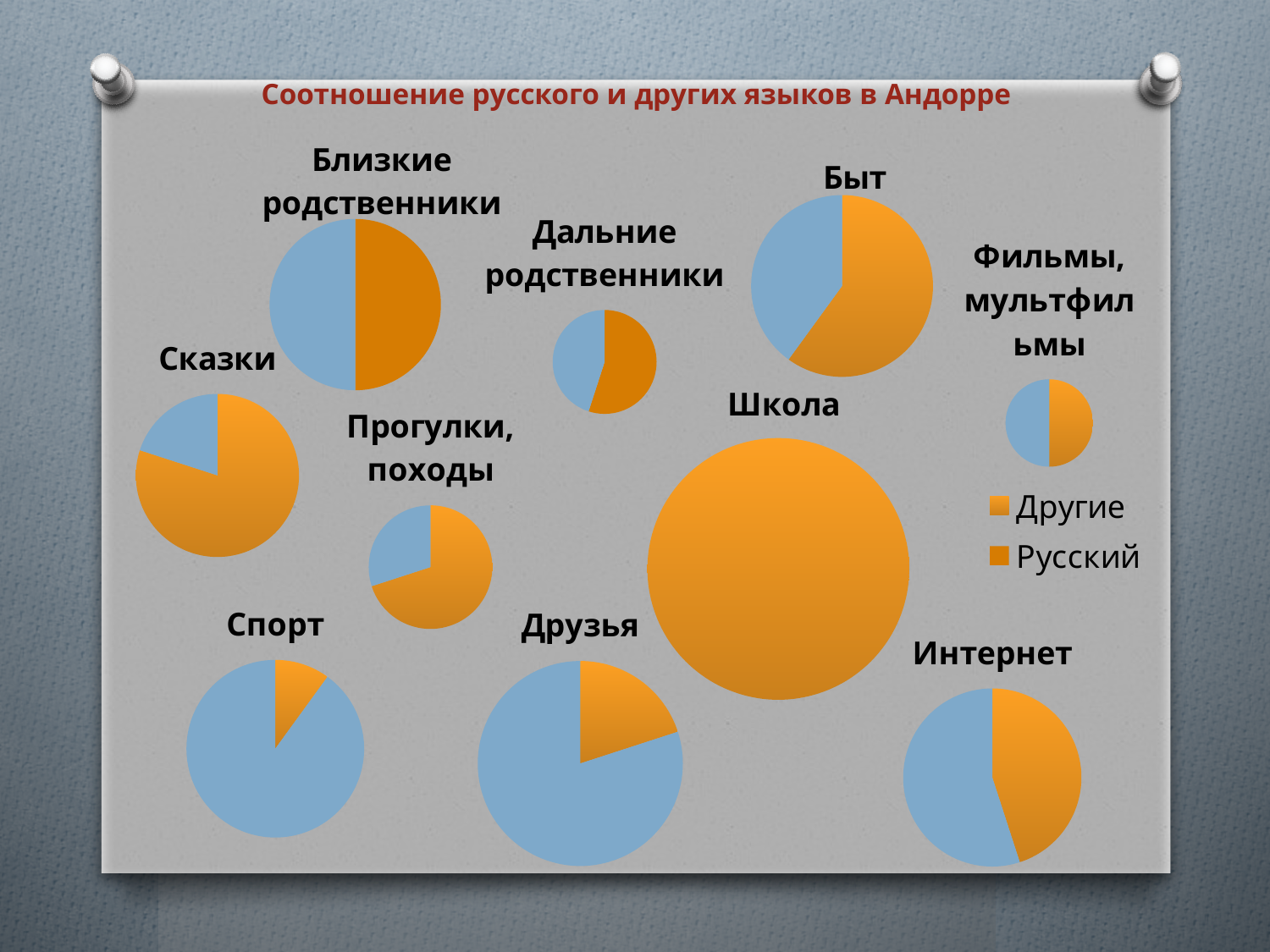
What are the two entries in the legend? Другие, Русский How many series does the legend list? 2 In the 'Быт' pie chart, which slice is larger, the blue one or the orange one? Orange Which pie chart on the slide has the smallest orange slice? Спорт What kind of charts are shown on the slide? Pie charts In the 'Прогулки, походы' pie chart, which slice is larger, the blue one or the orange one? Orange Which pie chart on the slide consists entirely of a single orange slice? Школа In the 'Спорт' pie chart, which slice is larger, the blue one or the orange one? Blue What is the title of the slide's set of charts? Соотношение русского и других языков в Андорре How many pie charts are on the slide? 10